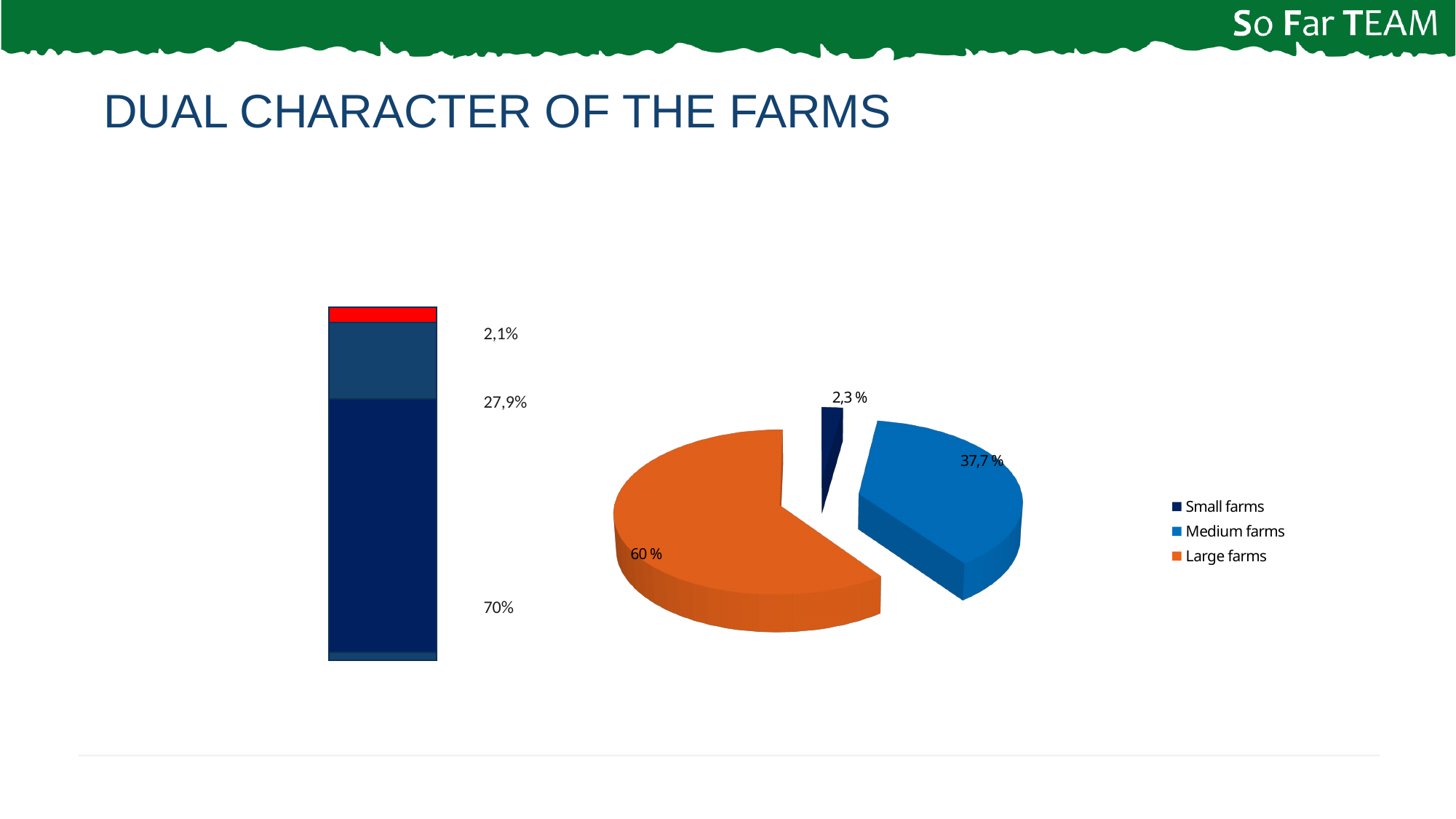
In the pie chart on the right, which category has the smallest slice? Small farms In the pie chart on the right, which category has the largest slice? Large farms In the pie chart on the right, how many categories does the legend list? 3 In the pie chart on the right, which is larger: the Medium farms slice or the Small farms slice? Medium farms In the pie chart on the right, what share do Medium farms have? 37,7 % In the stacked bar on the left, what value is labelled for the middle segment? 27,9% In the pie chart on the right, what share do Small farms have? 2,3 % In the stacked bar on the left, what value is labelled for the bottom (largest) segment? 70% In the pie chart on the right, what share do Large farms have? 60 % What kind of chart is shown on the left side of the slide? Bar chart In the stacked bar on the left, what value is labelled for the top (red) segment? 2,1% What kind of chart is shown on the right side of the slide? Pie chart